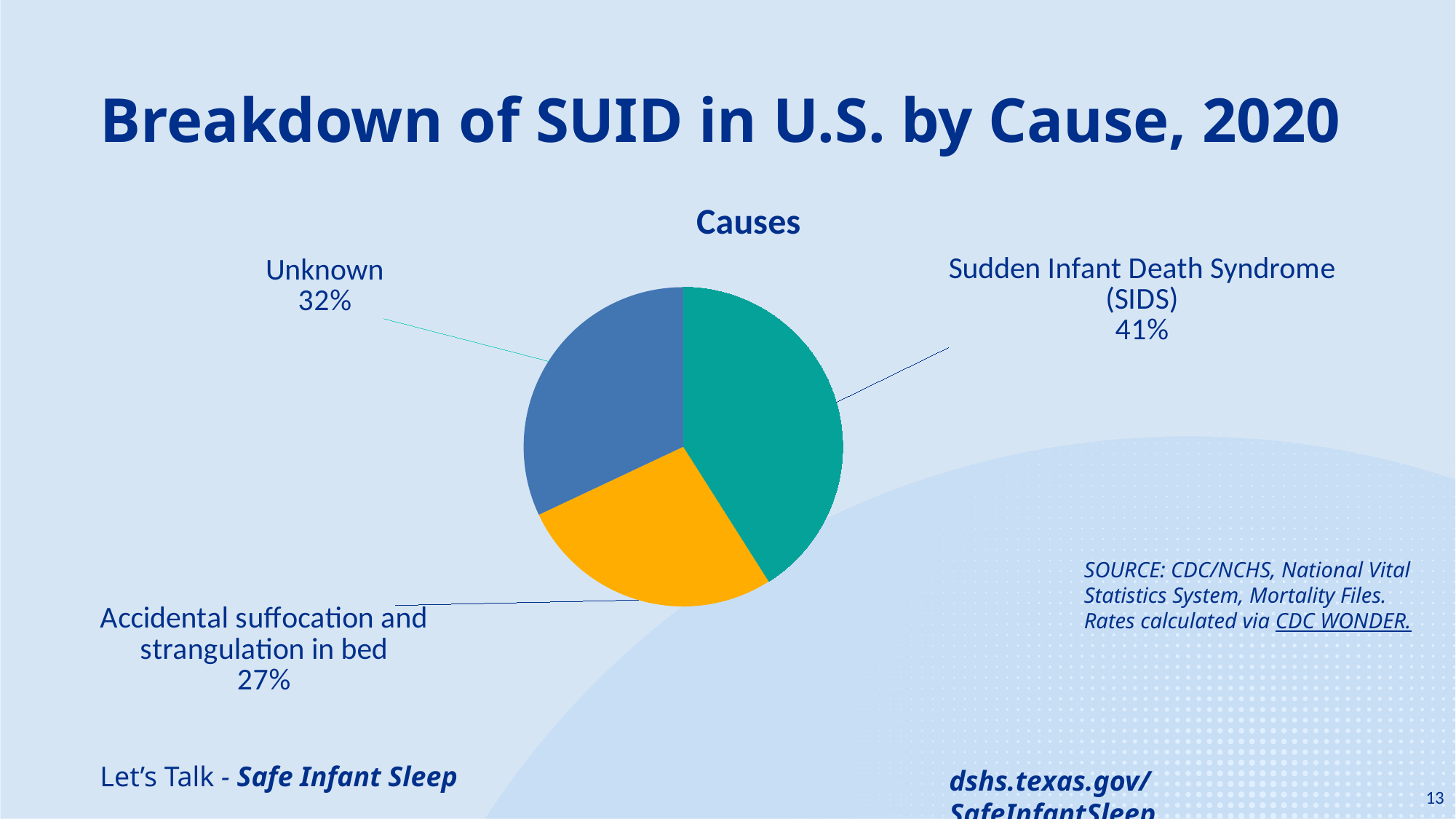
What share of SUID is attributed to Unknown causes? 32% What is the chart's title? Causes What is the difference in percentage points between the SIDS share and the Unknown share? 9 Which is larger: the share for Unknown or the share for Accidental suffocation and strangulation in bed? Unknown How many slices does the pie chart have? 3 What is the difference in percentage points between the Unknown share and the Accidental suffocation and strangulation in bed share? 5 What share of SUID is attributed to Sudden Infant Death Syndrome (SIDS)? 41% What colour is the slice for Sudden Infant Death Syndrome (SIDS)? teal What share of SUID is attributed to Accidental suffocation and strangulation in bed? 27% Which cause has the smallest share of the pie? Accidental suffocation and strangulation in bed What kind of chart is shown on the slide? pie chart Which cause has the largest share of the pie? Sudden Infant Death Syndrome (SIDS)